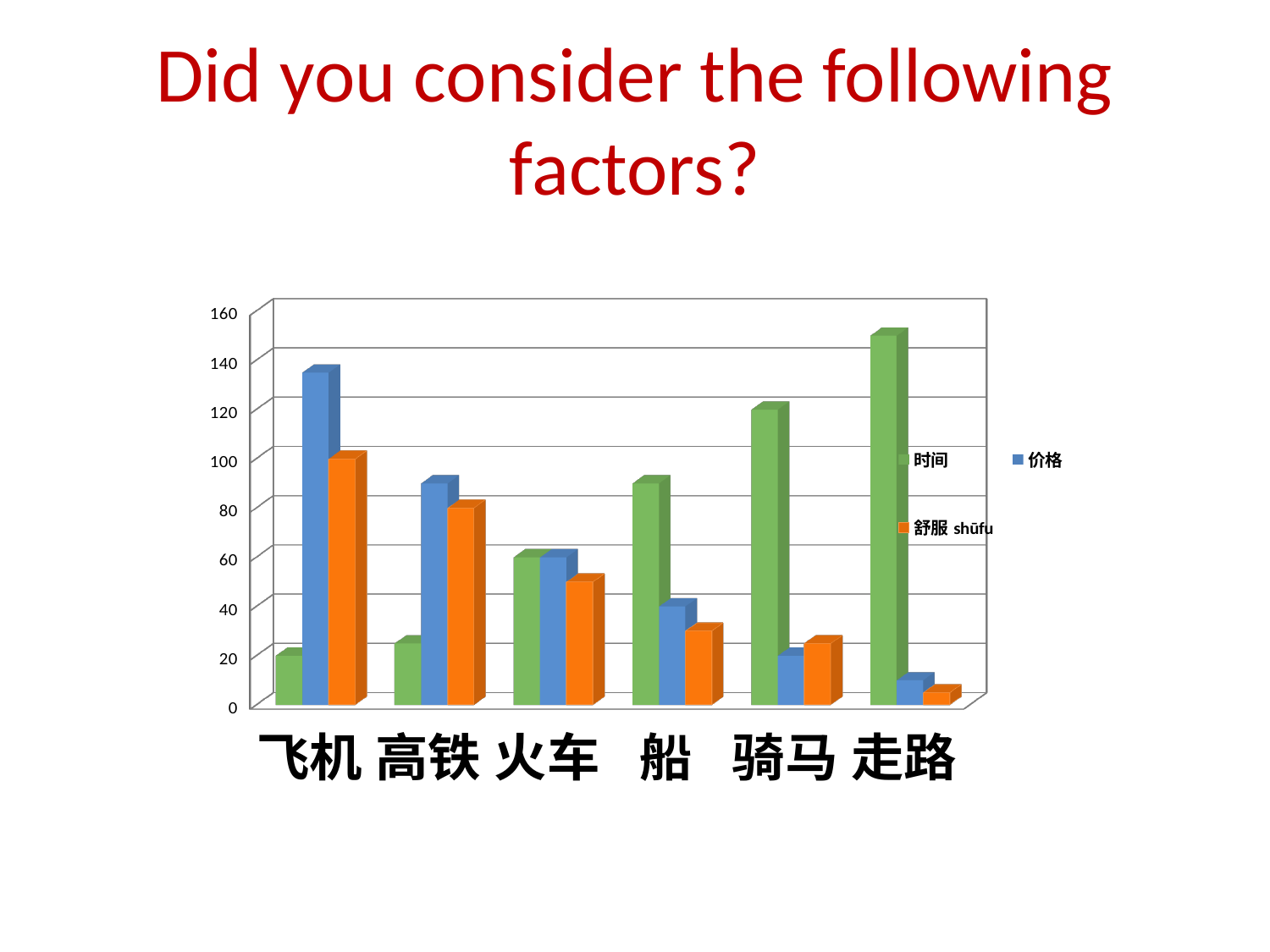
Do the 时间 values rise or fall moving from 飞机 to 走路 along the x axis? rise Which category has the lowest value for 舒服 shūfu? 走路 Is the 时间 value for 走路 greater or less than 140? greater What kind of chart is shown on the slide? bar chart Is the 价格 value for 飞机 greater or less than 120? greater Is the 舒服 shūfu value for 走路 greater or less than 20? less Which category has the lowest value for 时间? 飞机 How many categories are shown along the x axis of the chart? 6 For 船, which is larger: the 时间 value or the 价格 value? 时间 Which category has the highest value for 价格? 飞机 How many series does the chart's legend list? 3 Which category has the highest value for 时间? 走路